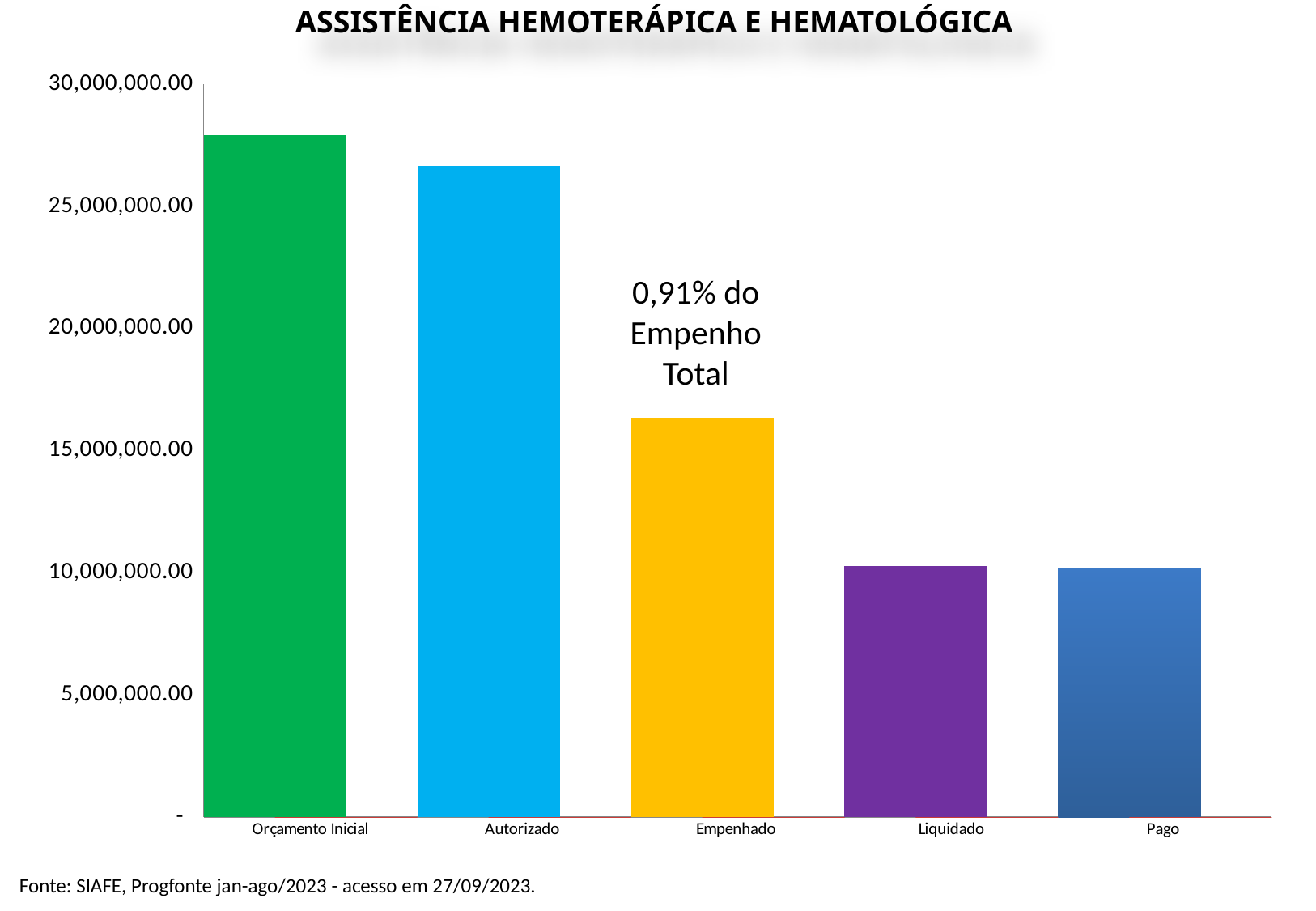
What kind of chart is shown on the slide? Bar chart Is the value for Empenhado greater or less than 15,000,000.00? greater How many categories are plotted on the x axis? 5 What is the title of the chart? ASSISTÊNCIA HEMOTERÁPICA E HEMATOLÓGICA What text annotation appears above the Empenhado bar? 0,91% do Empenho Total Which category has the highest value? Orçamento Inicial Is the value for Autorizado greater or less than 25,000,000.00? greater Is the value for Orçamento Inicial greater or less than 25,000,000.00? greater Which is larger, the value for Autorizado or the value for Empenhado? Autorizado Do the values rise or fall moving from left to right along the x axis? Fall